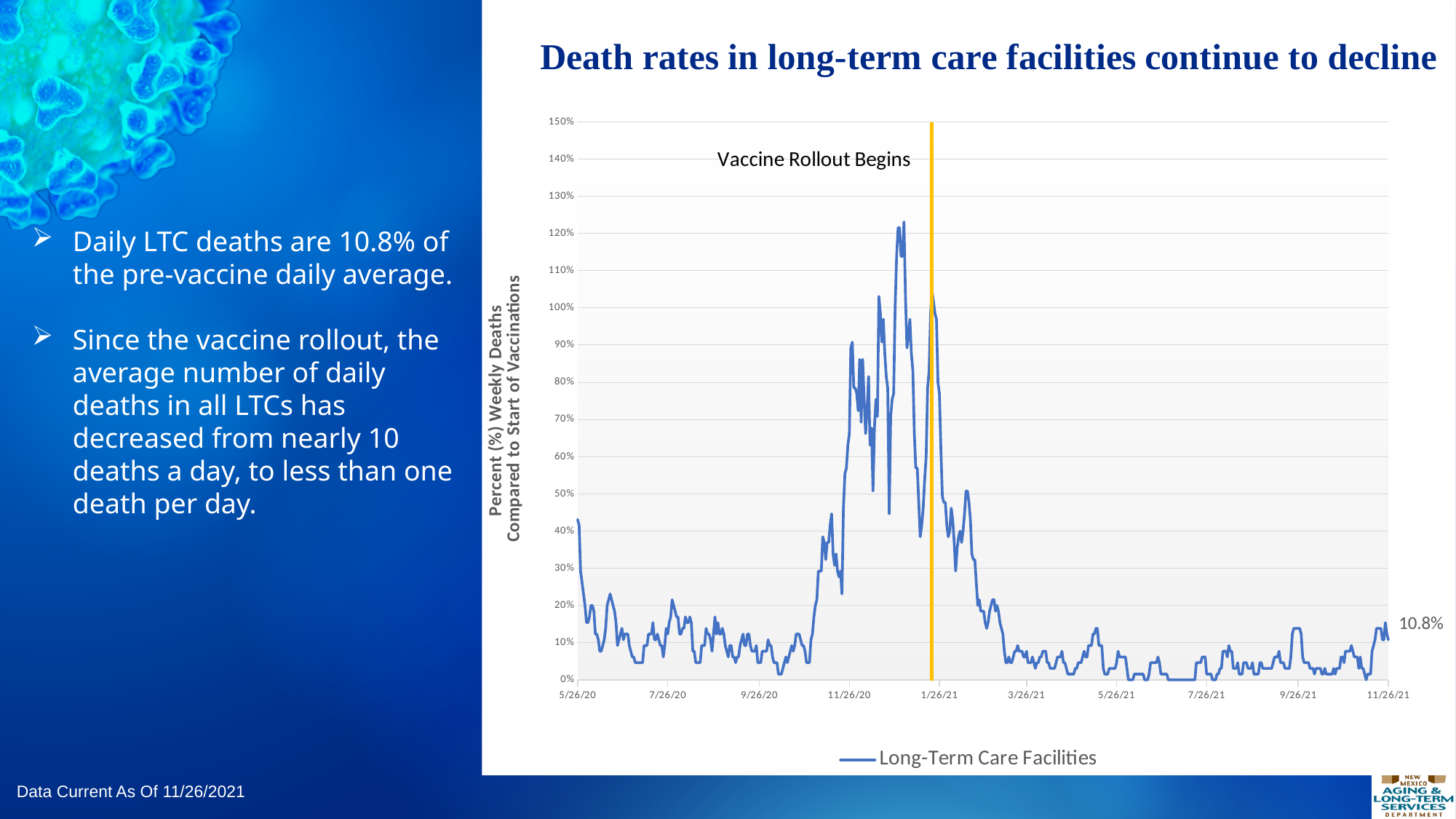
Which is larger: the value at 11/26/20 or the value at 7/26/21? 11/26/20 How many date labels are shown on the x axis? 10 How many series does the chart legend list? 1 From the peak in December 2020 to 11/26/21, do the values generally rise or fall? fall Is the value for Long-Term Care Facilities at 3/26/21 greater or less than 50%? less What does the annotation next to the vertical orange line on the chart say? Vaccine Rollout Begins What is the value labeled at the end of the line, at 11/26/21? 10.8% Is the value for Long-Term Care Facilities at 7/26/21 greater or less than 10%? less What kind of chart is shown on the slide? line chart Is the highest peak of the line greater or less than 110%? greater What is the name of the series shown in the chart legend? Long-Term Care Facilities